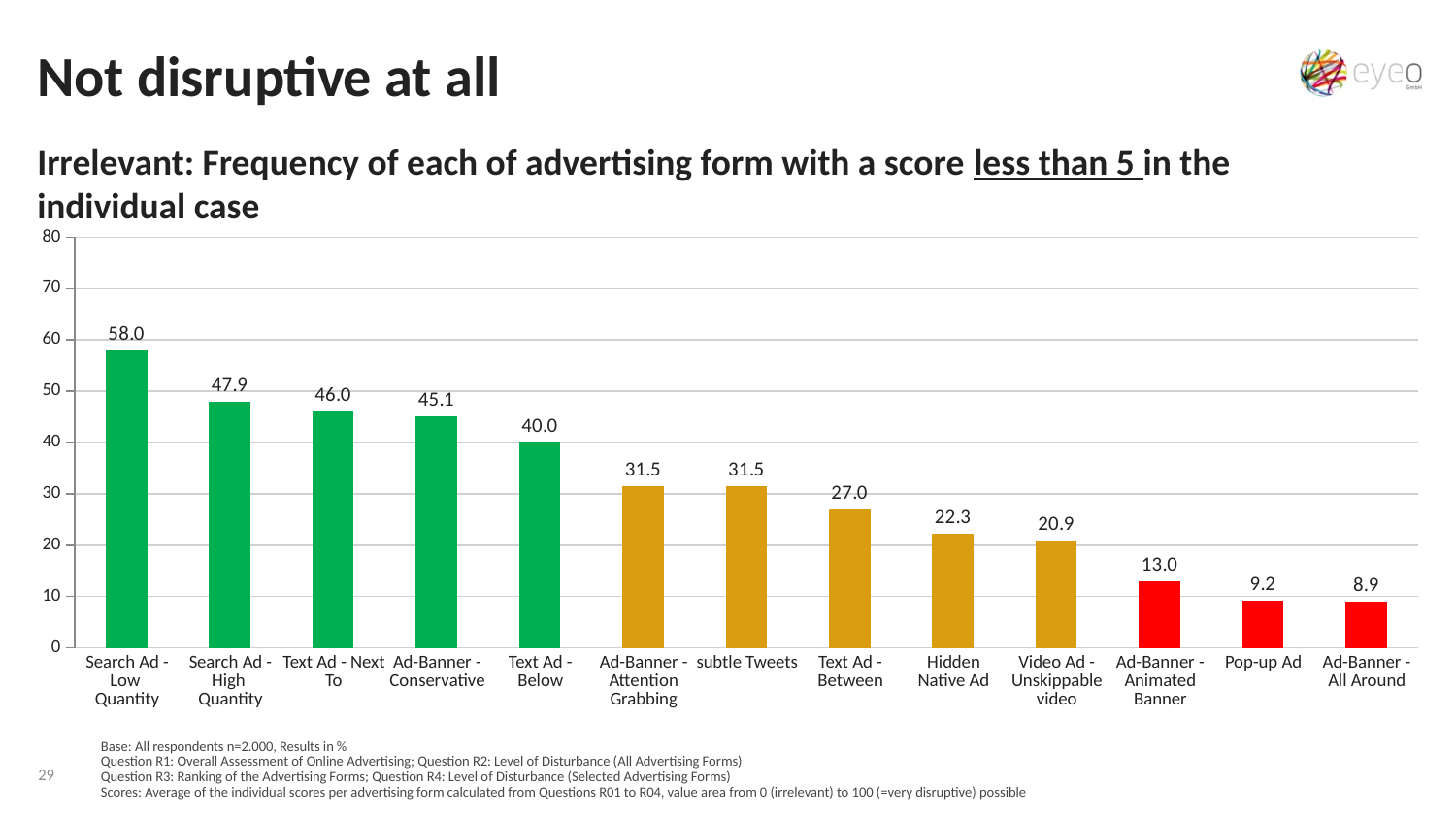
What is the difference between the values for Search Ad - Low Quantity and Search Ad - High Quantity? 10.1 What is the value for Hidden Native Ad? 22.3 Do the values rise or fall from left to right along the x axis? fall Which advertising form has the highest value? Search Ad - Low Quantity What is the value for Pop-up Ad? 9.2 How many advertising forms are shown on the chart? 13 What colour are the bars for Pop-up Ad and Ad-Banner - All Around? red Which advertising form has the lowest value? Ad-Banner - All Around What kind of chart is shown on the slide? bar chart What is the value for Search Ad - Low Quantity? 58.0 Is the value for Video Ad - Unskippable video greater or less than 30? less Which is larger, the value for Text Ad - Below or the value for Text Ad - Between? Text Ad - Below